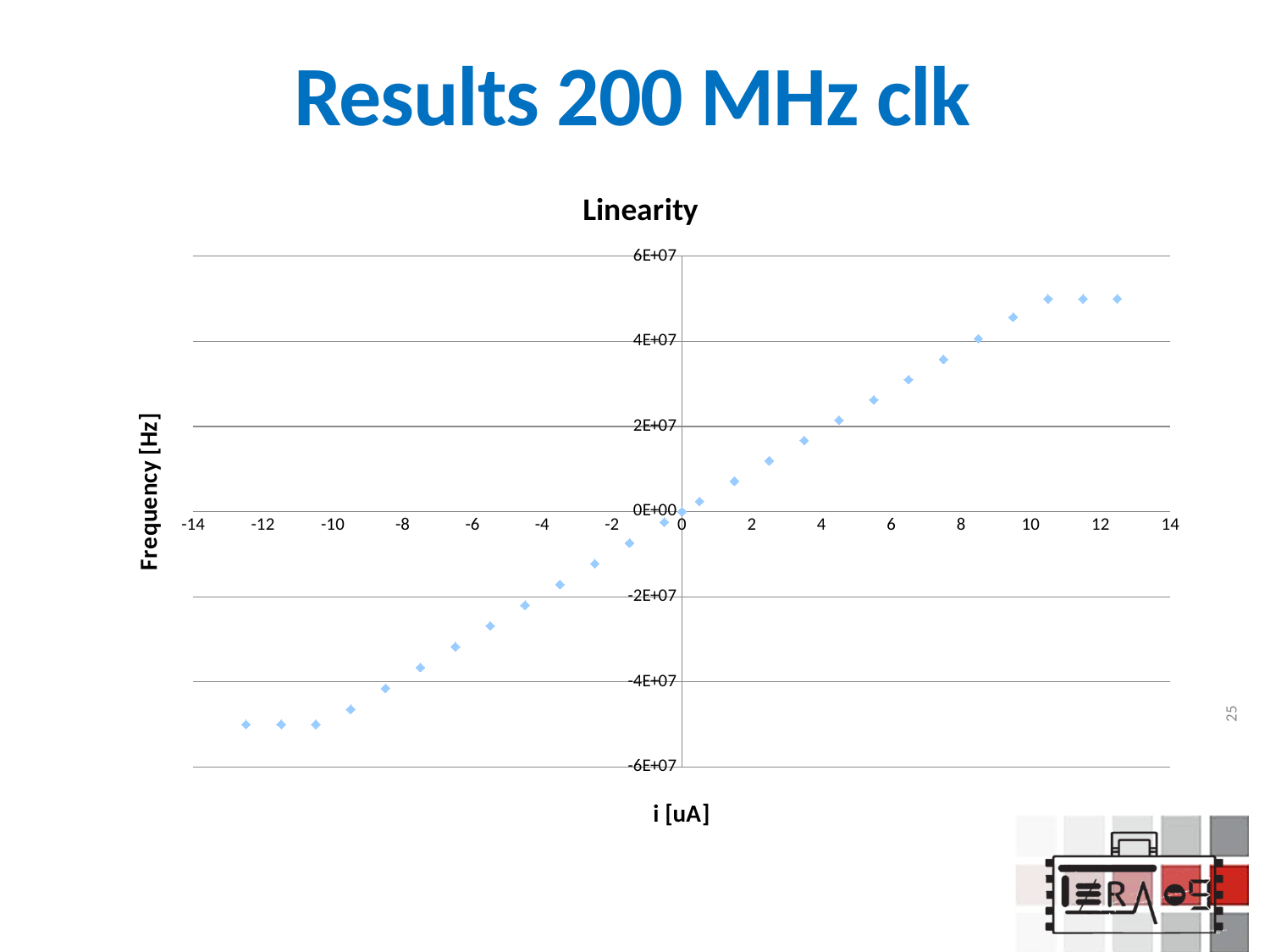
What is the title of the chart? Linearity Is the frequency value at i = 6 uA greater or less than 2E+07? greater Which is larger, the frequency value at i = 10 uA or at i = 4 uA? i = 10 uA Is the frequency value at i = 8 uA greater or less than 2E+07? greater Is the frequency value at i = -6 uA greater or less than -2E+07? less What is the label of the y axis of the chart? Frequency [Hz] What kind of chart is shown on the slide? scatter chart Do the plotted frequency values rise or fall as i [uA] increases along the x axis? rise